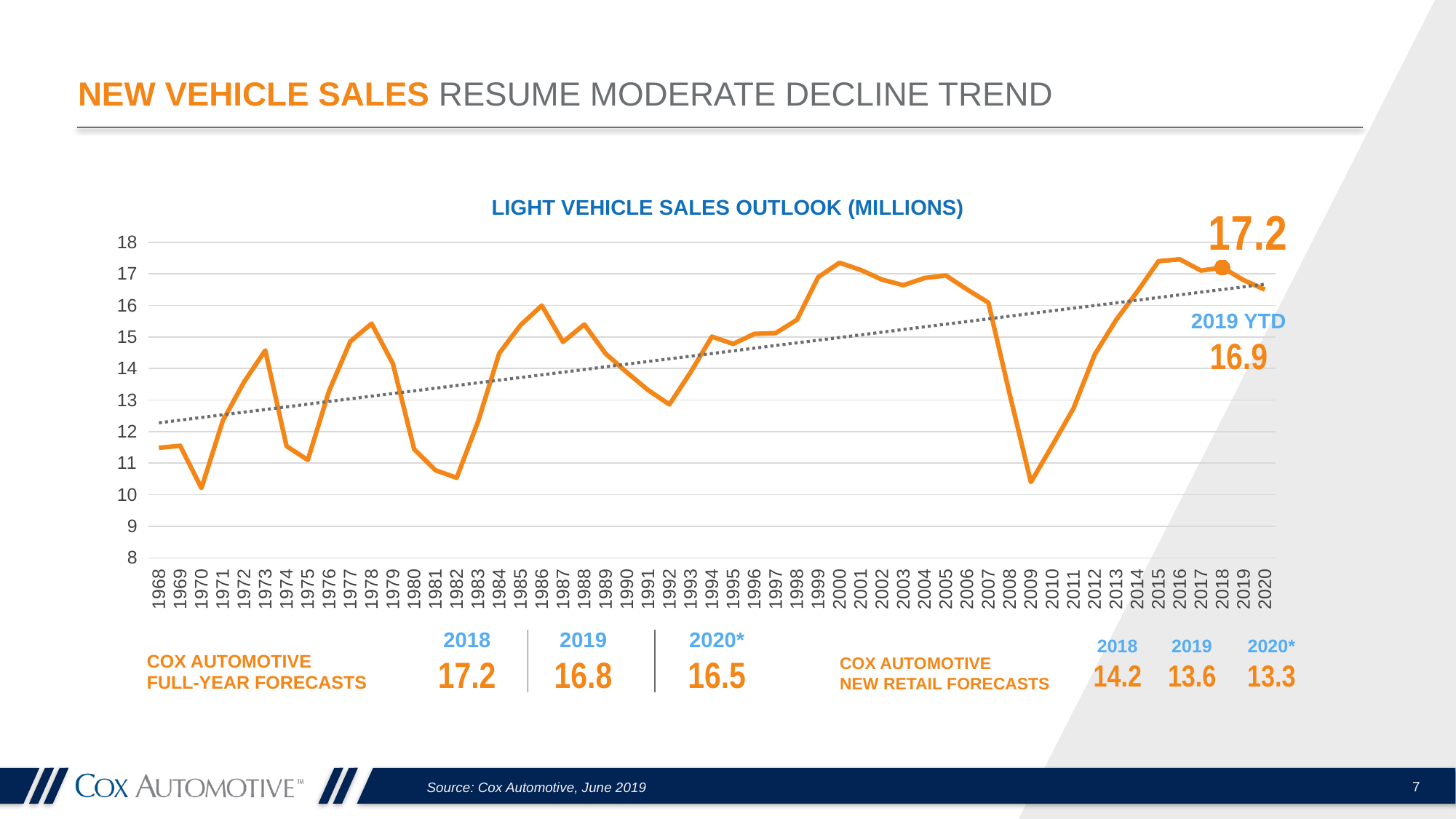
Is the value for 1986 greater or less than 15? greater Is the value for 2000 greater or less than 17? greater Is the value for 2009 greater or less than 11? less How many years are shown on the x axis of the chart? 53 What 2019 YTD value is annotated on the chart? 16.9 What value is labelled on the chart for 2018? 17.2 Which year has the larger value, 1973 or 1975? 1973 What is the title of the chart? LIGHT VEHICLE SALES OUTLOOK (MILLIONS) Which year has the larger value, 2000 or 2009? 2000 What kind of chart is shown on the slide? line chart Do the values rise or fall from 2016 to 2020? fall